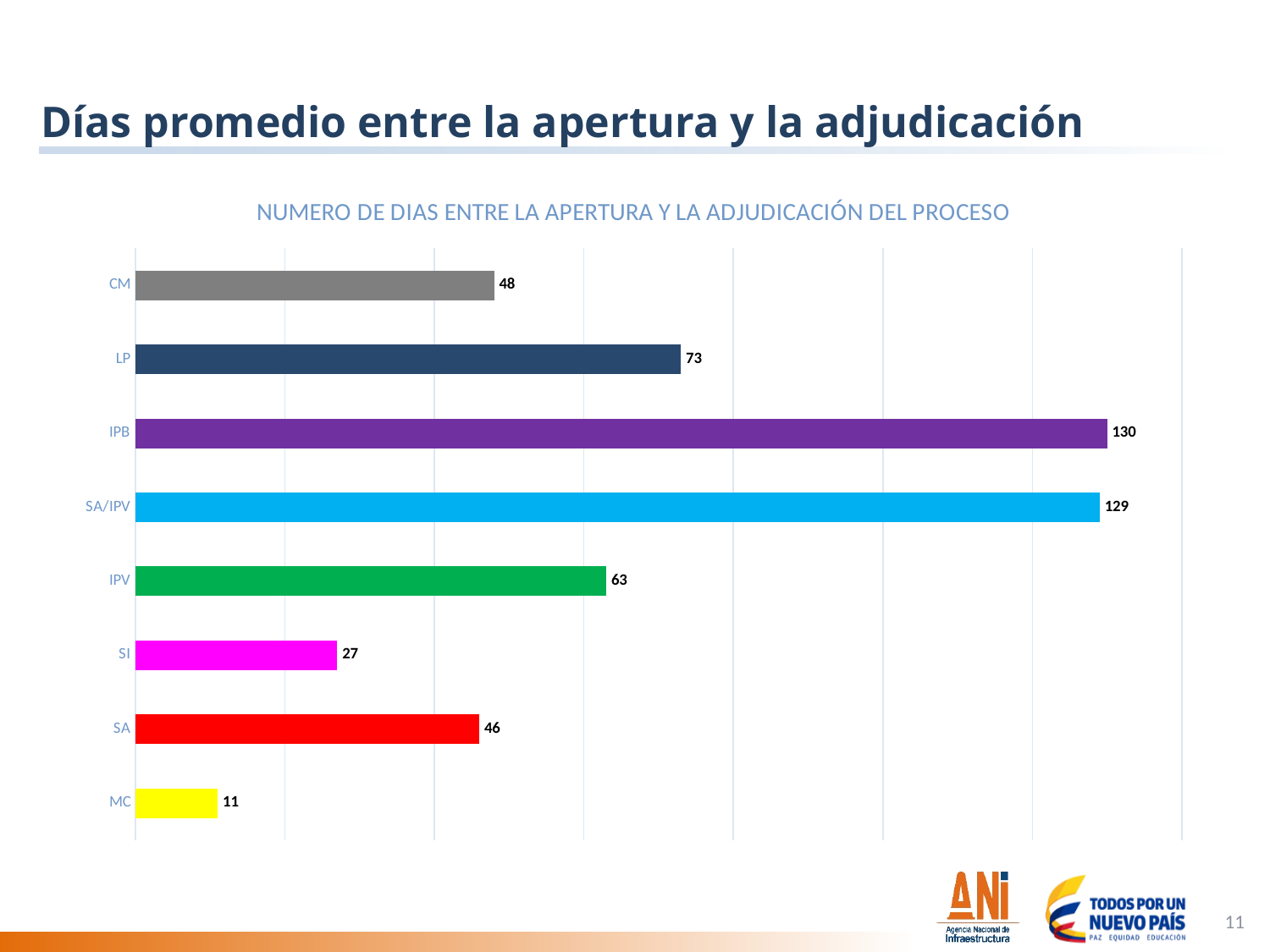
What is the value for IPB? 130 What is the value for SA/IPV? 129 What is the value for MC? 11 What is the value for LP? 73 What is the difference between the values for LP and CM? 25 How many categories are shown in the chart? 8 Which is larger, the value for IPV or the value for SA? IPV What is the difference between the values for IPB and SA/IPV? 1 What kind of chart is shown on the slide? Bar chart What is the title of the chart? NUMERO DE DIAS ENTRE LA APERTURA Y LA ADJUDICACIÓN DEL PROCESO Which category has the lowest value? MC Which is larger, the value for SI or the value for CM? CM